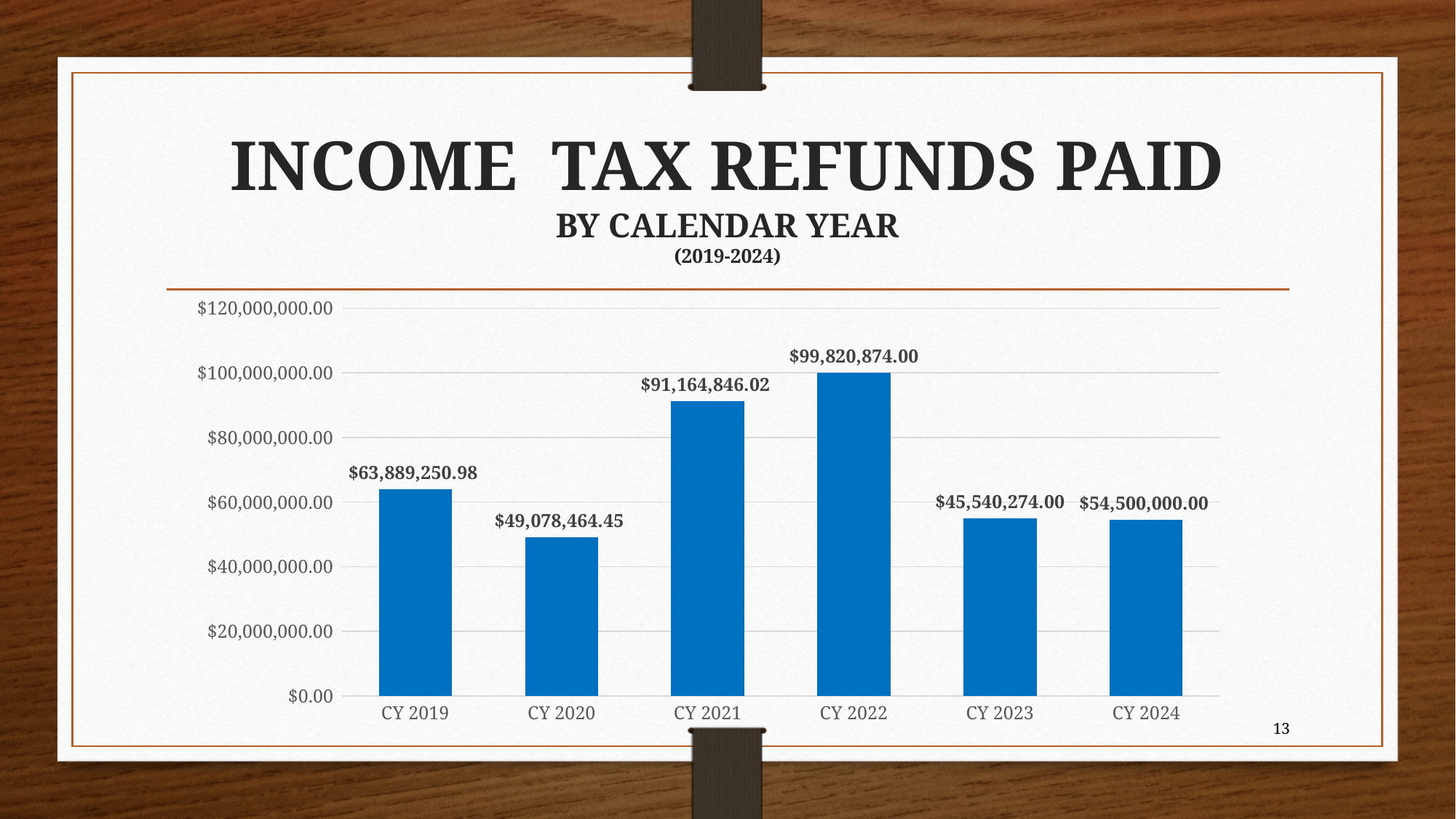
How many calendar years are shown in the chart? 6 What kind of chart is used to show the income tax refunds paid? Bar chart How much more was paid in refunds in CY 2024 than in CY 2023? $8,959,726.00 What was the income tax refund amount paid in CY 2022? $99,820,874.00 Is the value for CY 2021 greater or less than $80,000,000.00? greater Which calendar year had the highest income tax refunds paid? CY 2022 What was the income tax refund amount paid in CY 2024? $54,500,000.00 Which year had larger income tax refunds paid, CY 2019 or CY 2020? CY 2019 What was the income tax refund amount paid in CY 2019? $63,889,250.98 Did the income tax refunds paid rise or fall from CY 2022 to CY 2023? Fall What is the difference between the refunds paid in CY 2022 and CY 2021? $8,656,027.98 Which calendar year had the lowest income tax refunds paid? CY 2023